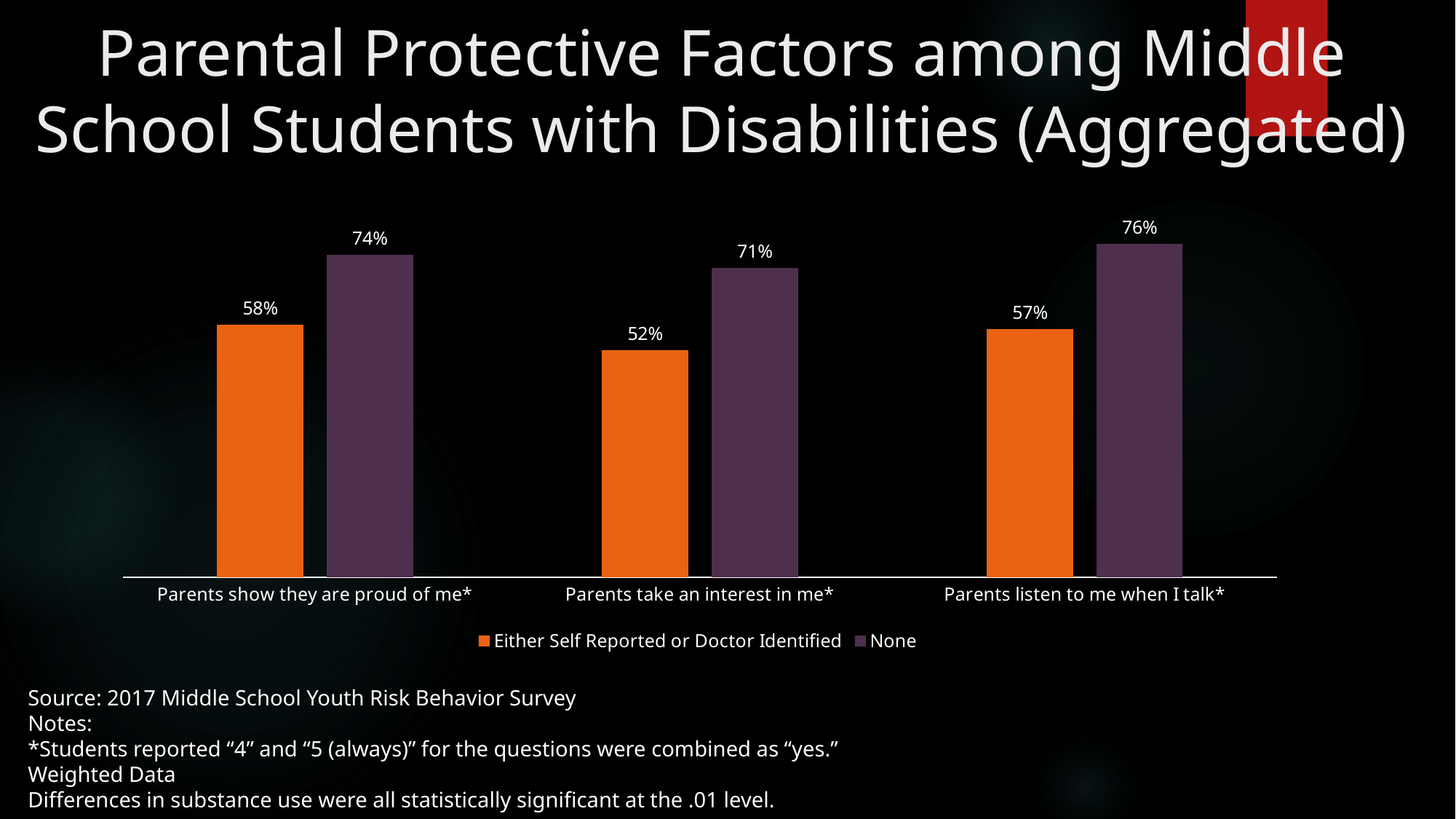
Which category has the lowest value for the 'Either Self Reported or Doctor Identified' series? Parents take an interest in me* What is the value for the None series for 'Parents listen to me when I talk*'? 76% What is the difference between the None and 'Either Self Reported or Doctor Identified' values for 'Parents take an interest in me*'? 19% For 'Parents show they are proud of me*', which series has the larger value? None Which category has the highest value for the None series? Parents listen to me when I talk* How many categories are shown on the x axis? 3 What kind of chart is shown on the slide? Bar chart How many series does the legend list? 2 What percentage of students with a disability (Either Self Reported or Doctor Identified) reported that parents show they are proud of them? 58% What is the value for 'Either Self Reported or Doctor Identified' for 'Parents take an interest in me*'? 52% What is the value for the None series for 'Parents take an interest in me*'? 71% What is the difference between the None and 'Either Self Reported or Doctor Identified' values for 'Parents listen to me when I talk*'? 19%